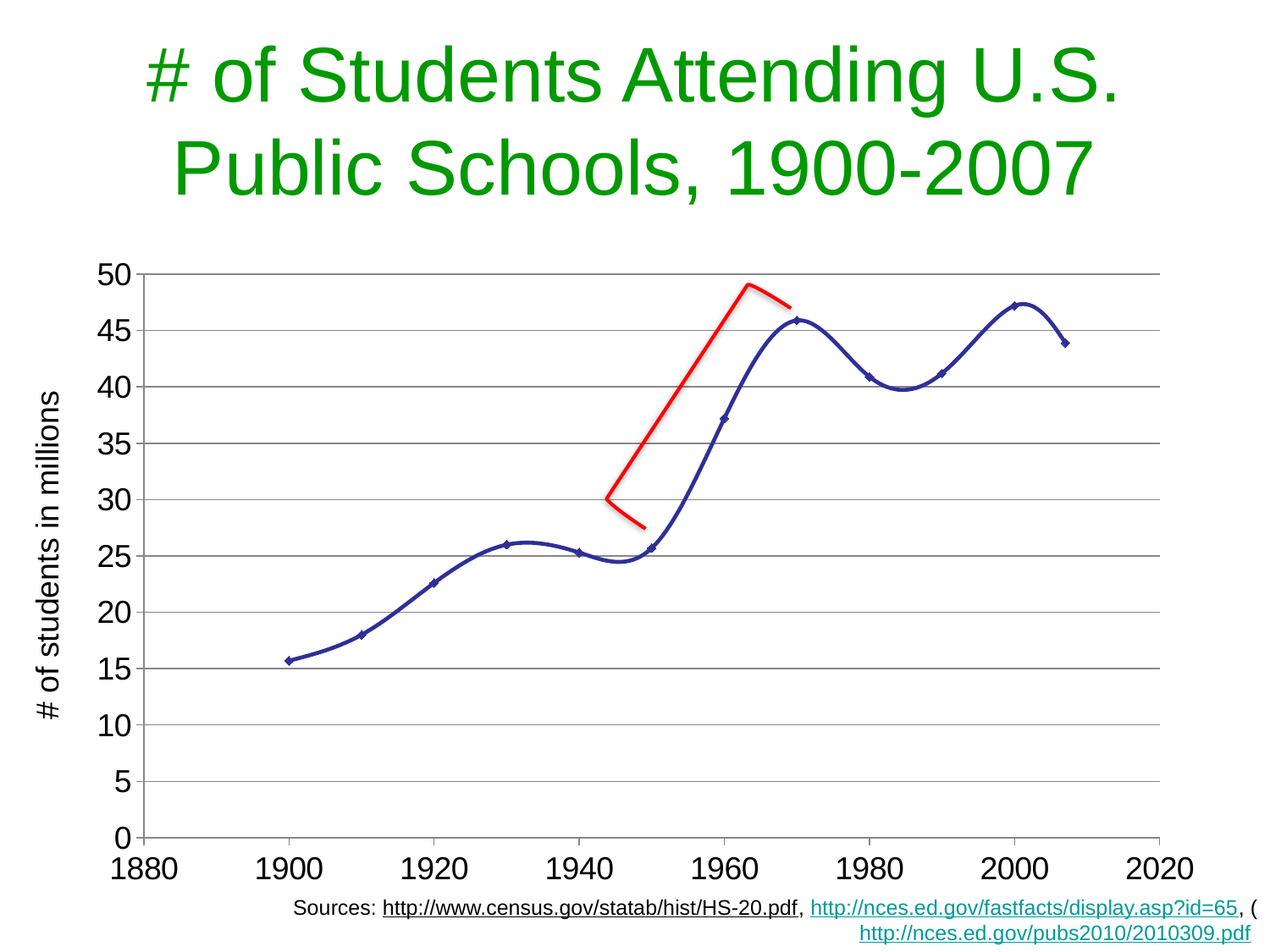
Is the value for 1970 greater or less than 40? greater Overall, do the values rise or fall from 1900 to 2007? rise Is the value for 1900 greater or less than 20? less What kind of chart is shown on the slide? line chart What is the title of the chart on the slide? # of Students Attending U.S. Public Schools, 1900-2007 What is the label of the vertical axis? # of students in millions Which is larger, the value for 1950 or the value for 1960? 1960 Which is larger, the value for 1970 or the value for 1980? 1970 Which year has the lowest number of students? 1900 How many data points are plotted on the chart? 12 Is the value for 1960 greater or less than 35? greater